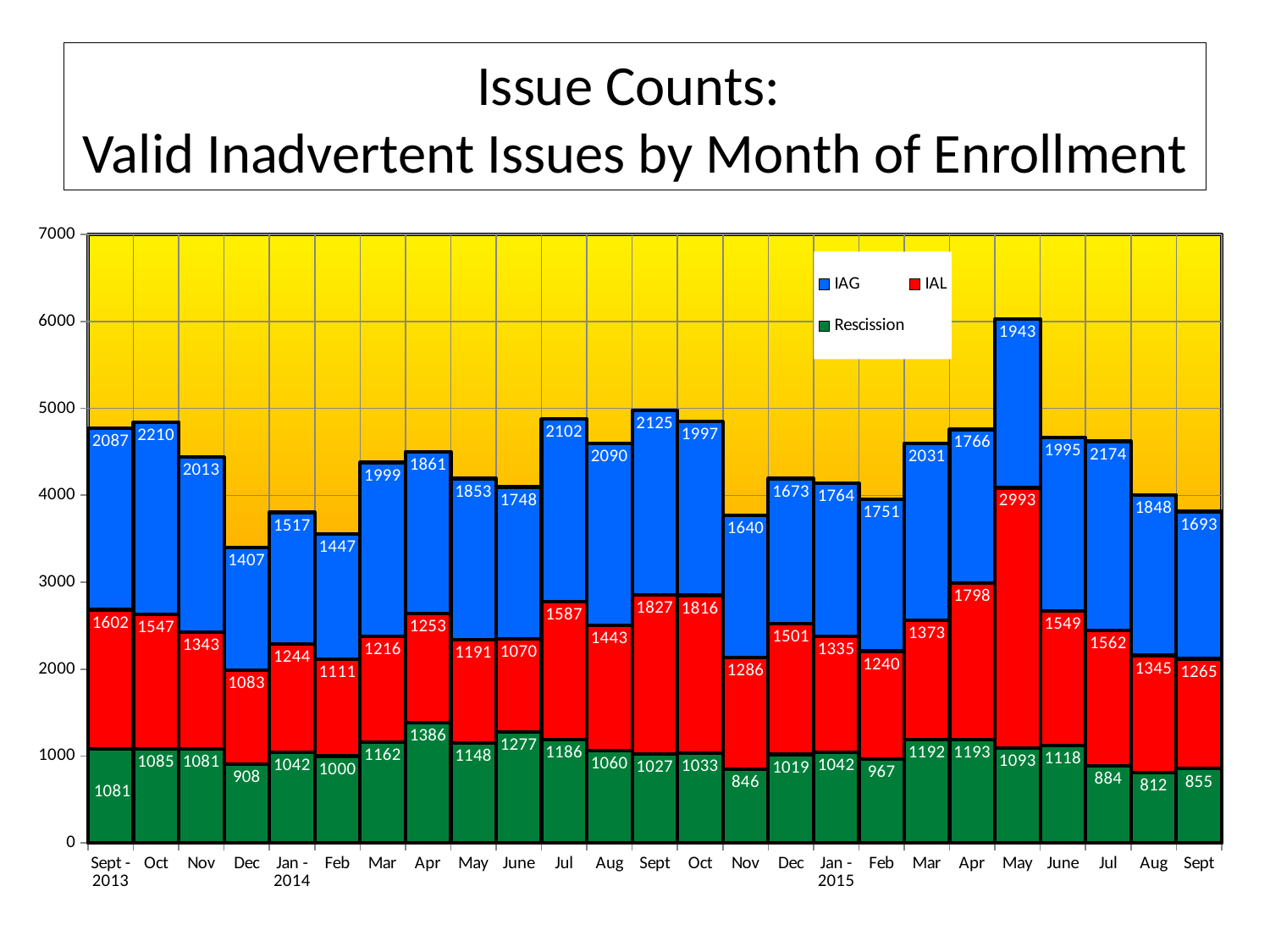
Which month has the lowest Rescission value? Aug 2015 What is the IAL value for May 2015? 2993 Which month has the highest IAL value? May 2015 What is the Rescission value for Apr 2014? 1386 What is the IAG value for Jul 2015? 2174 Which is larger, the IAL value for Sept 2014 or the IAL value for Oct 2014? Sept 2014 What is the difference between the IAG values for Oct 2013 and Sept 2013? 123 What is the total of the stacked bar for May 2015? 6029 What type of chart is shown on the slide? stacked bar chart Is the total of the stacked bar for Dec 2013 greater or less than 4000? less How many series does the legend list? 3 How many months (bars) are plotted in the chart? 25